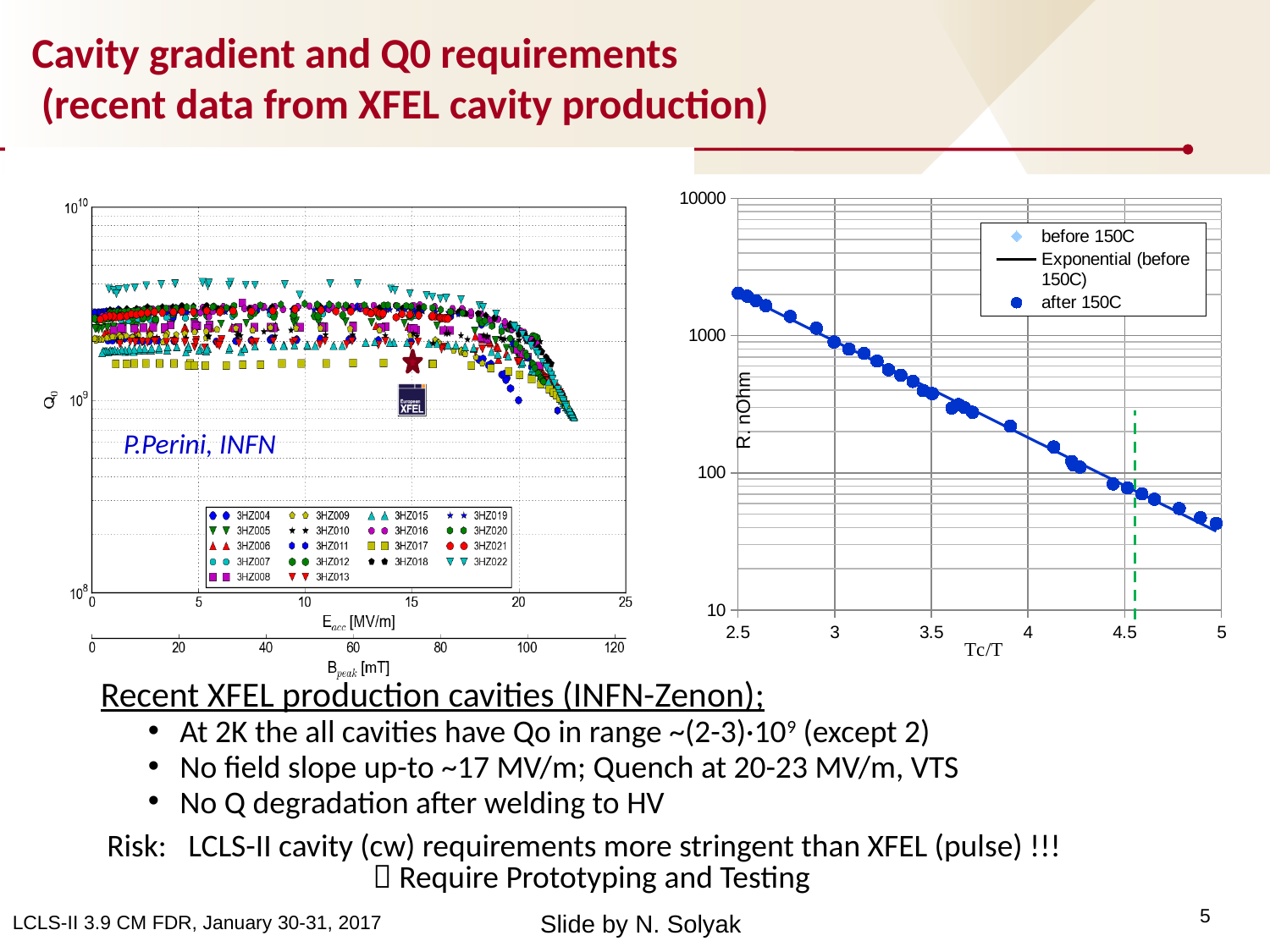
In the right-hand chart (R vs Tc/T), which is larger: the R value at Tc/T = 3 or at Tc/T = 4.5? Tc/T = 3 What kind of chart is the left-hand chart (Q0 vs Eacc)? scatter plot In the right-hand chart (R vs Tc/T), is the R value at Tc/T = 4 greater or less than 100? greater In the right-hand chart (R vs Tc/T), is the R value at Tc/T = 5 greater or less than 100? less In the right-hand chart (R vs Tc/T), do the R values rise or fall as Tc/T increases? fall How many entries does the legend of the right-hand chart (R vs Tc/T) list? 3 What kind of chart is the right-hand chart (R vs Tc/T)? scatter plot What is the label of the lower x axis of the left-hand chart (Q0 vs Eacc)? Eacc [MV/m] What is the label of the x axis of the right-hand chart? Tc/T How many cavity series does the legend of the left-hand chart (Q0 vs Eacc) list? 18 In the right-hand chart (R vs Tc/T), is the R value at Tc/T = 4 greater or less than 1000? less